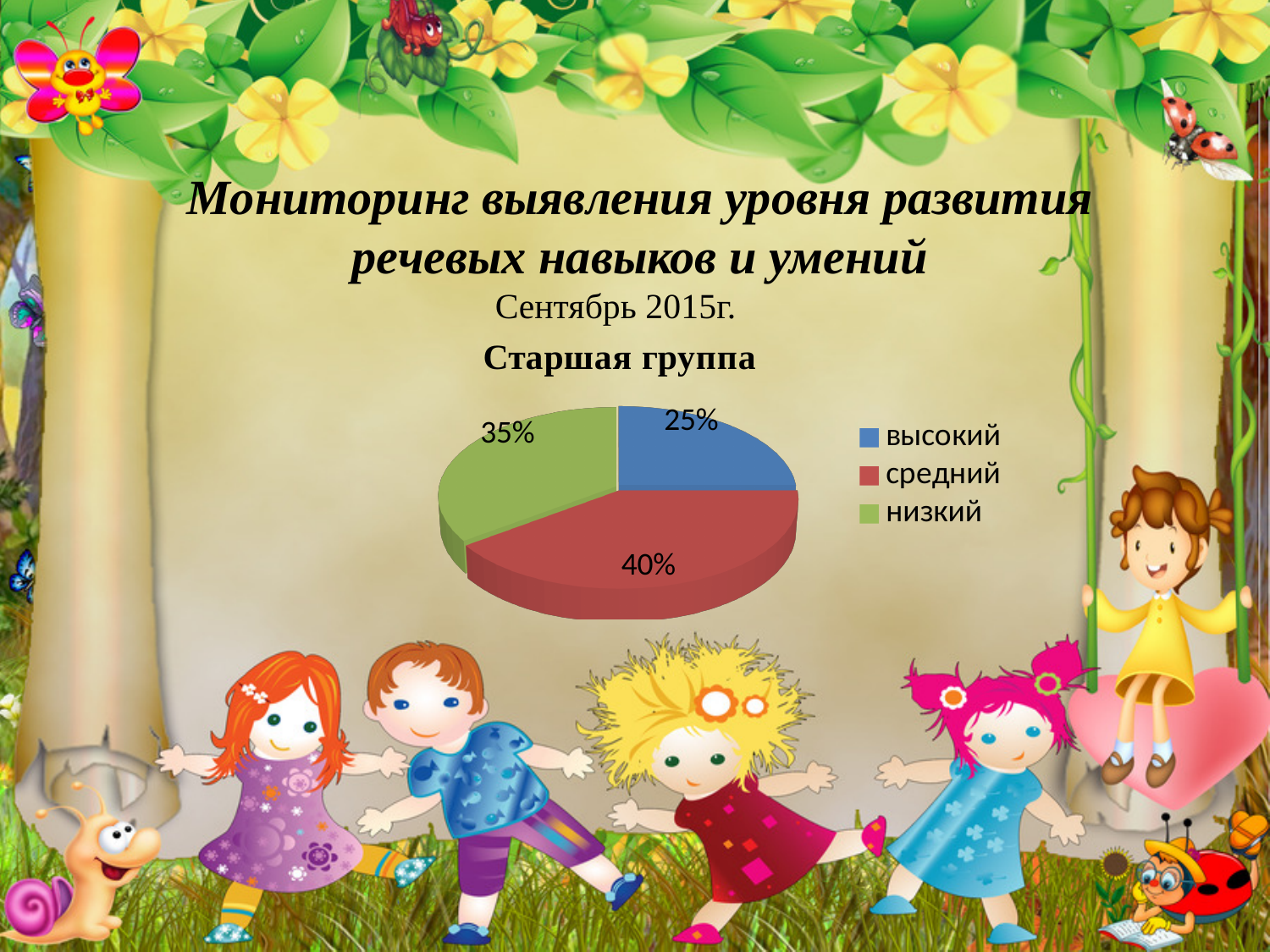
What is the difference between the values for средний and высокий? 15% What is the title of the chart? Старшая группа What is the difference between the values for низкий and высокий? 10% Which category has the smallest share of the pie? высокий What kind of chart is shown on the slide? pie chart What is the value for высокий? 25% Which category has the largest share of the pie? средний What is the value for средний? 40% How many categories does the legend list? 3 Which colour represents низкий in the chart? green Which is larger, the value for низкий or the value for средний? средний What is the value for низкий? 35%